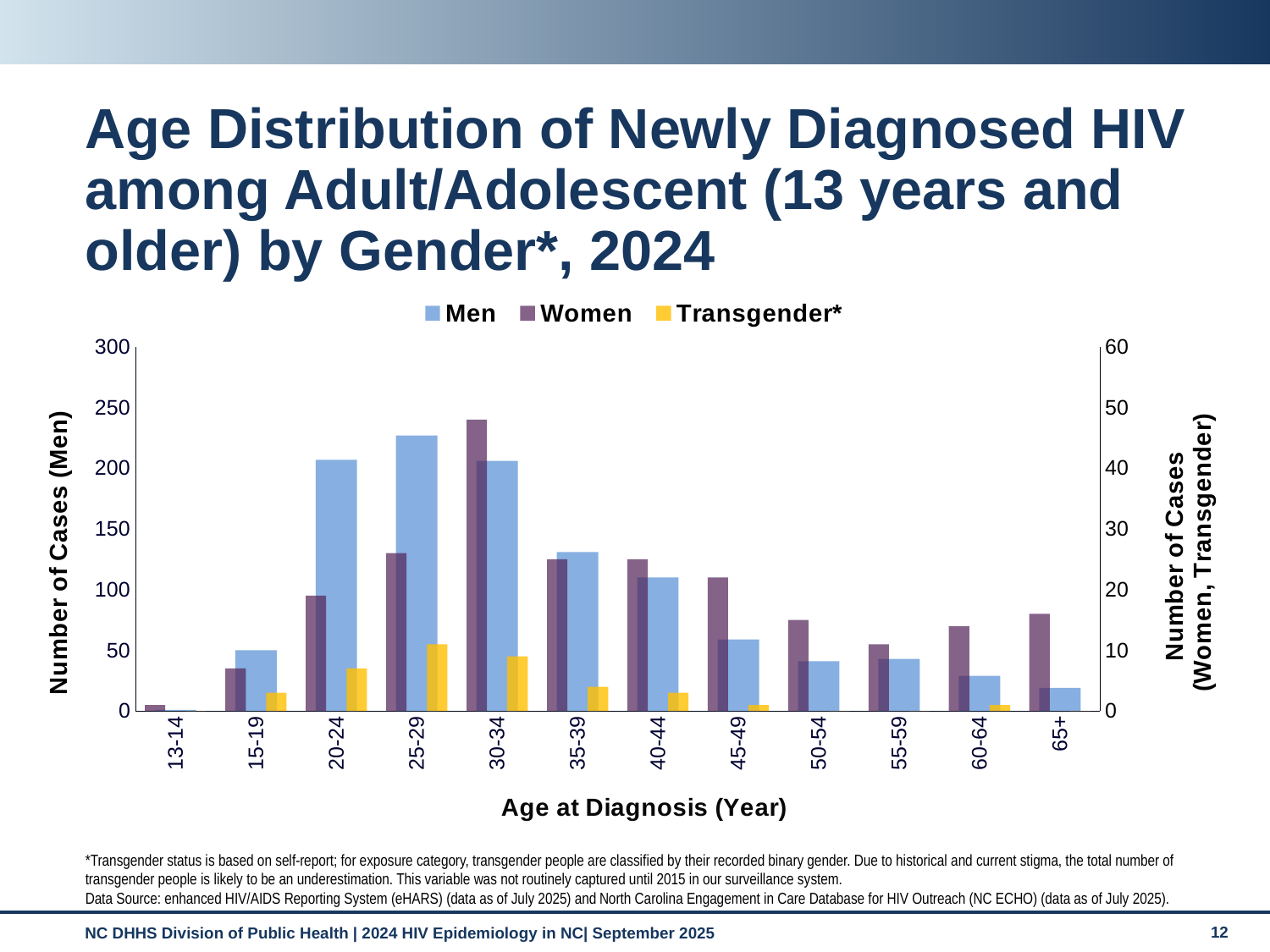
For Men, which age group has more cases: 20-24 or 15-19? 20-24 How many age groups are shown on the x axis? 12 How many series does the legend list? 3 What type of chart is shown on the slide? Bar chart Is the value for Men in the 35-39 age group greater or less than 100? greater Is the value for Women in the 30-34 age group greater or less than 40? greater Which age group has the highest number of cases for Women? 30-34 Is the value for Women in the 50-54 age group greater or less than 20? less Which age group has the highest number of cases for Transgender? 25-29 Do the values for Men rise or fall from the 25-29 age group to the 65+ age group? Fall Which age group has the highest number of cases for Men? 25-29